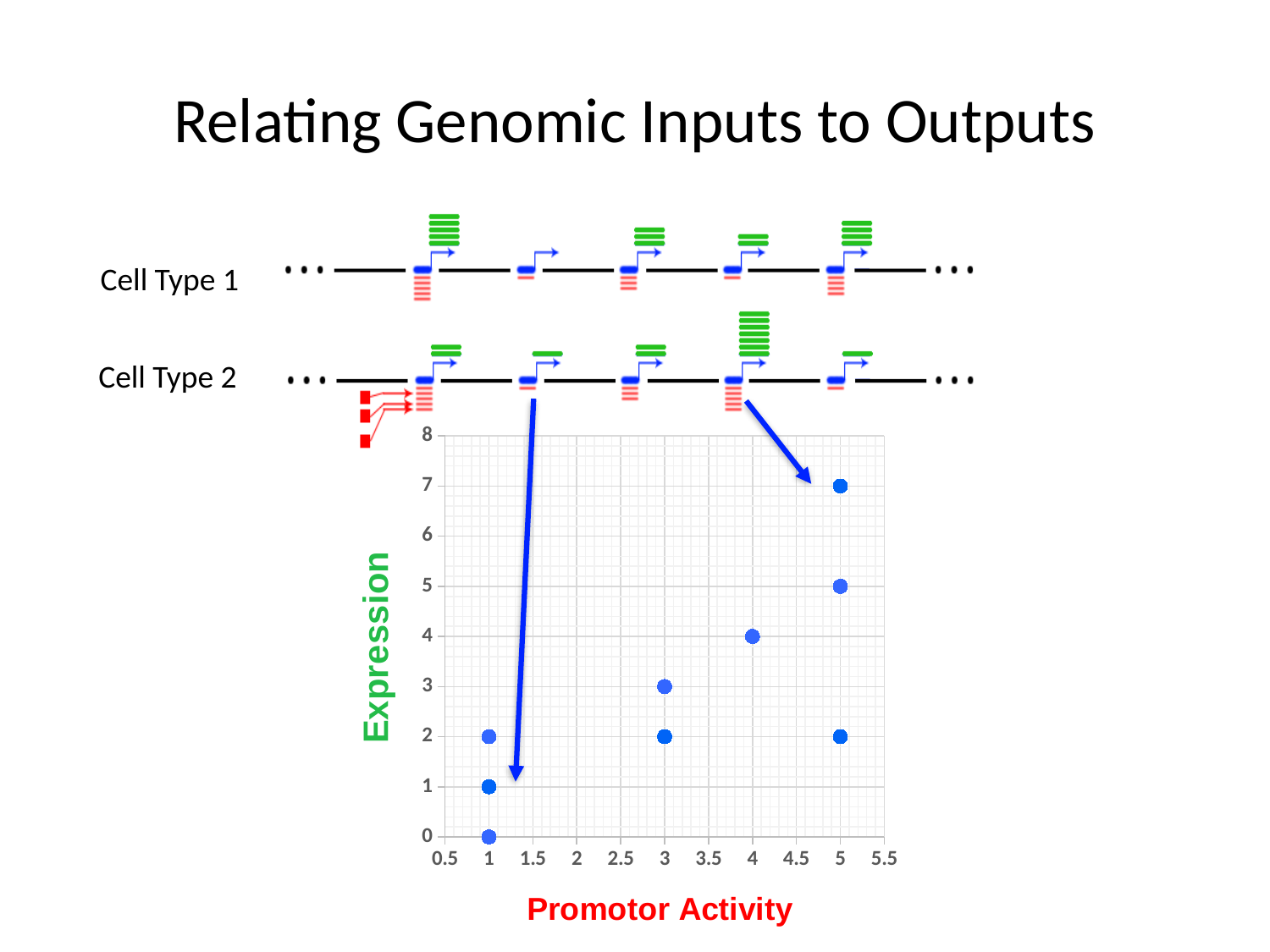
Does Expression generally rise or fall as Promotor Activity increases along the x axis? rise What is the label of the x axis of the scatter chart? Promotor Activity How many data points are plotted in the scatter chart? 9 What is the highest Expression value plotted in the scatter chart? 7 What is the label of the y axis of the scatter chart? Expression What kind of chart is shown on the slide? scatter chart What is the difference between the highest and lowest Expression values plotted at a Promotor Activity of 5? 5 How many points are plotted at a Promotor Activity of 5? 3 What is the Expression value of the single point plotted at a Promotor Activity of 4? 4 At which Promotor Activity value does the point with the highest Expression occur? 5 What is the lowest Expression value plotted in the scatter chart? 0 How many points are plotted at a Promotor Activity of 1? 3